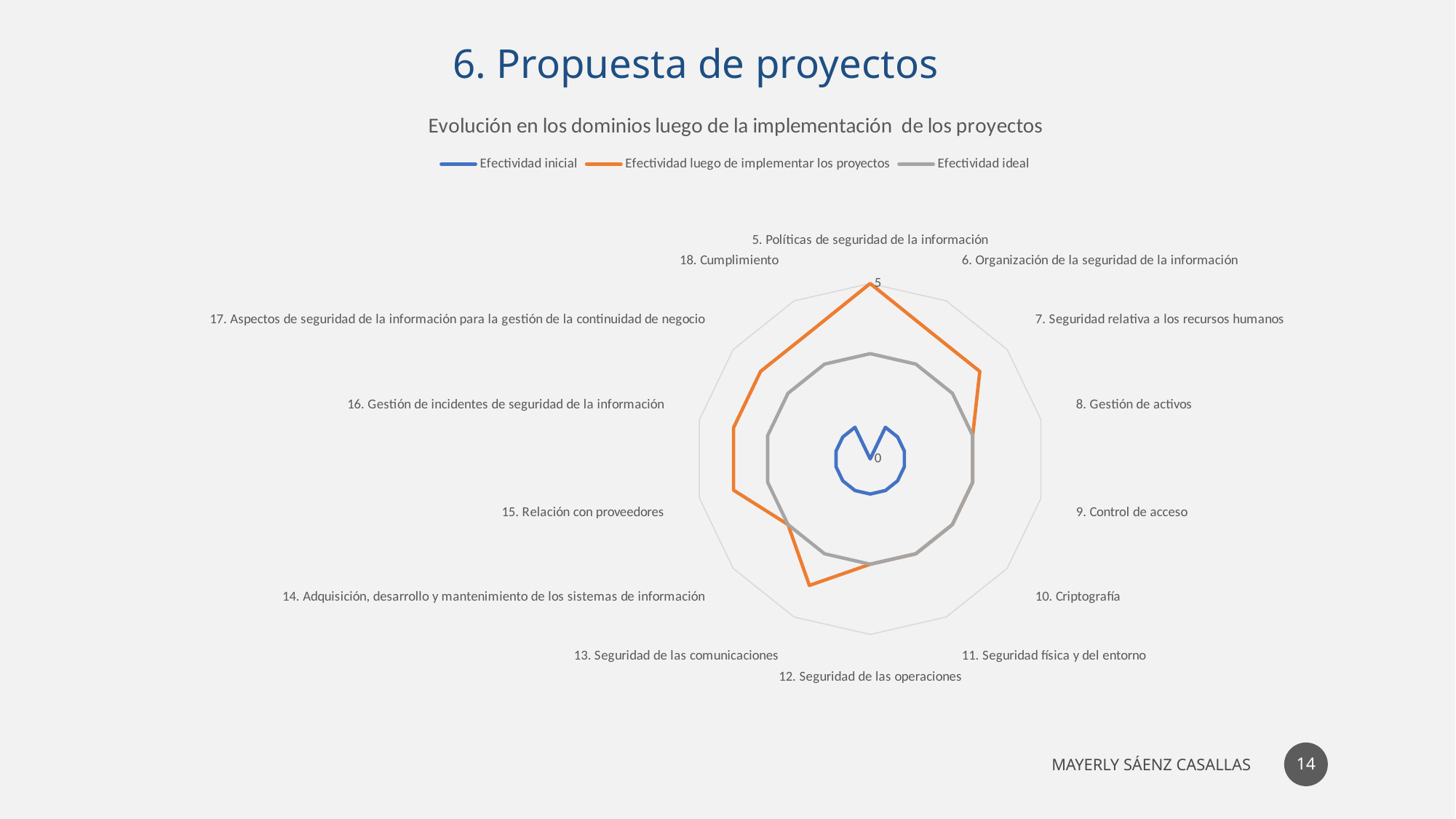
For '12. Seguridad de las operaciones', which is larger: 'Efectividad inicial' or 'Efectividad ideal'? Efectividad ideal What kind of chart is shown on the slide? Radar chart What is the value of 'Efectividad luego de implementar los proyectos' for '5. Políticas de seguridad de la información'? 5 How many series does the legend list? 3 For '5. Políticas de seguridad de la información', which is larger: 'Efectividad inicial' or 'Efectividad luego de implementar los proyectos'? Efectividad luego de implementar los proyectos Which series is drawn in orange? Efectividad luego de implementar los proyectos What is the maximum value shown on the radar chart's axis? 5 What is the title of the chart? Evolución en los dominios luego de la implementación de los proyectos How many categories (domains) are plotted on the radar chart? 14 For '15. Relación con proveedores', which is larger: 'Efectividad ideal' or 'Efectividad luego de implementar los proyectos'? Efectividad luego de implementar los proyectos For which category does the 'Efectividad luego de implementar los proyectos' series reach its highest value? 5. Políticas de seguridad de la información Which series has the lowest values across all categories? Efectividad inicial